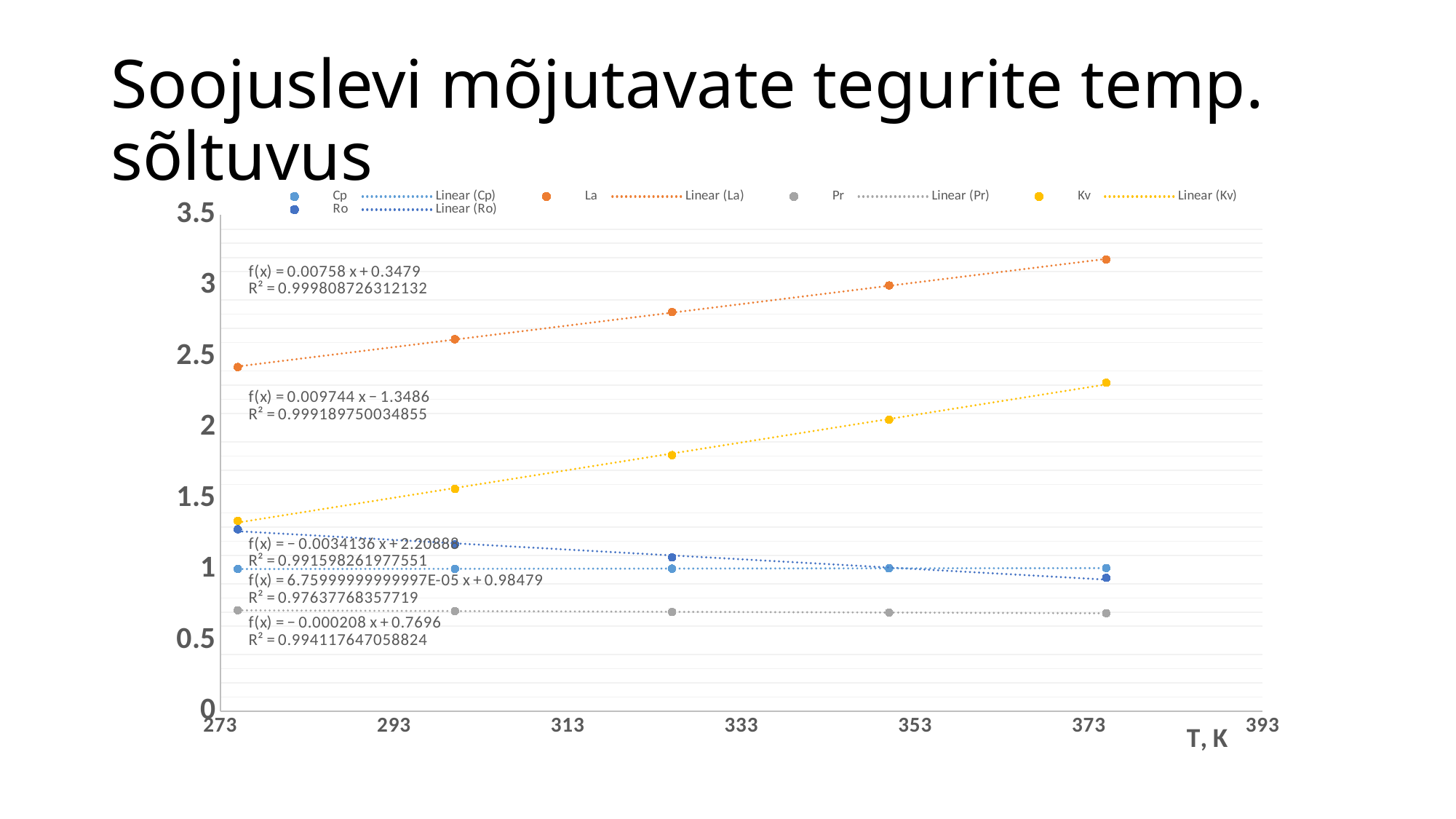
Which series has the lowest values across the whole temperature range? Pr Is the value of the La series at its highest temperature point greater or less than 3? greater Do the values of the Kv series rise or fall as temperature increases? rise How many data points does the La series have? 5 Which series has the highest values across the whole temperature range? La What is the label of the x axis? T, K At the highest temperature point, which series has the larger value, La or Kv? La How many entries does the chart legend list? 10 Do the values of the Ro series rise or fall as temperature increases? fall How many data series with markers (excluding the linear trendlines) are plotted on the chart? 5 What kind of chart is shown on the slide? scatter chart Is the value of the Kv series at its lowest temperature point greater or less than 1.5? less